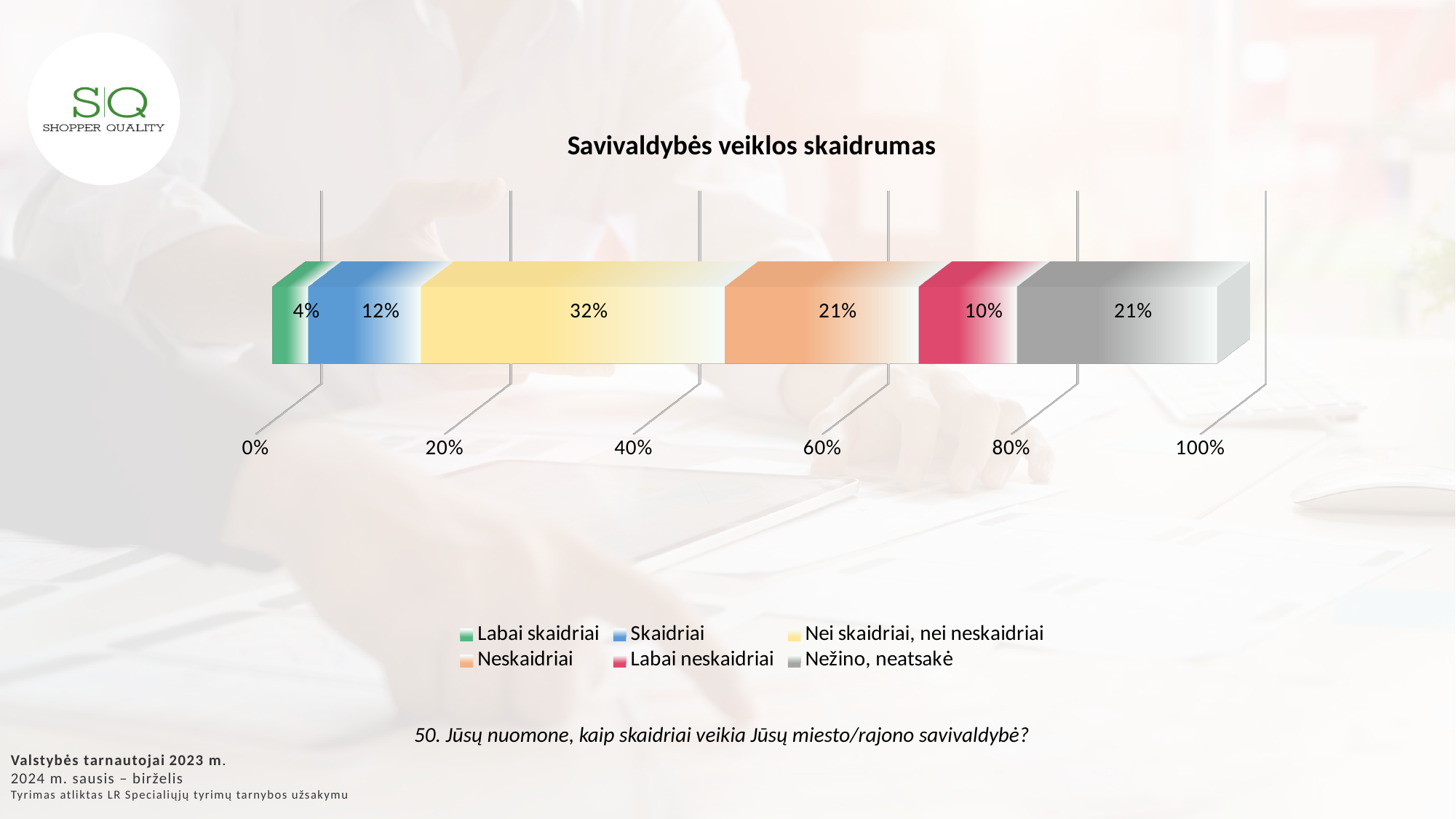
What is the title of the chart? Savivaldybės veiklos skaidrumas What kind of chart is shown on the slide? Stacked bar chart What is the value for "Labai skaidriai"? 4% What is the difference between the values for "Nei skaidriai, nei neskaidriai" and "Neskaidriai"? 11% Which category has the highest value? Nei skaidriai, nei neskaidriai What is the value for "Skaidriai"? 12% Which category has the lowest value? Labai skaidriai Which is larger, the value for "Skaidriai" or the value for "Labai neskaidriai"? Skaidriai What is the value for "Nei skaidriai, nei neskaidriai"? 32% What is the value for "Labai neskaidriai"? 10% What is the total of the stacked bar? 100% How many series does the legend list? 6